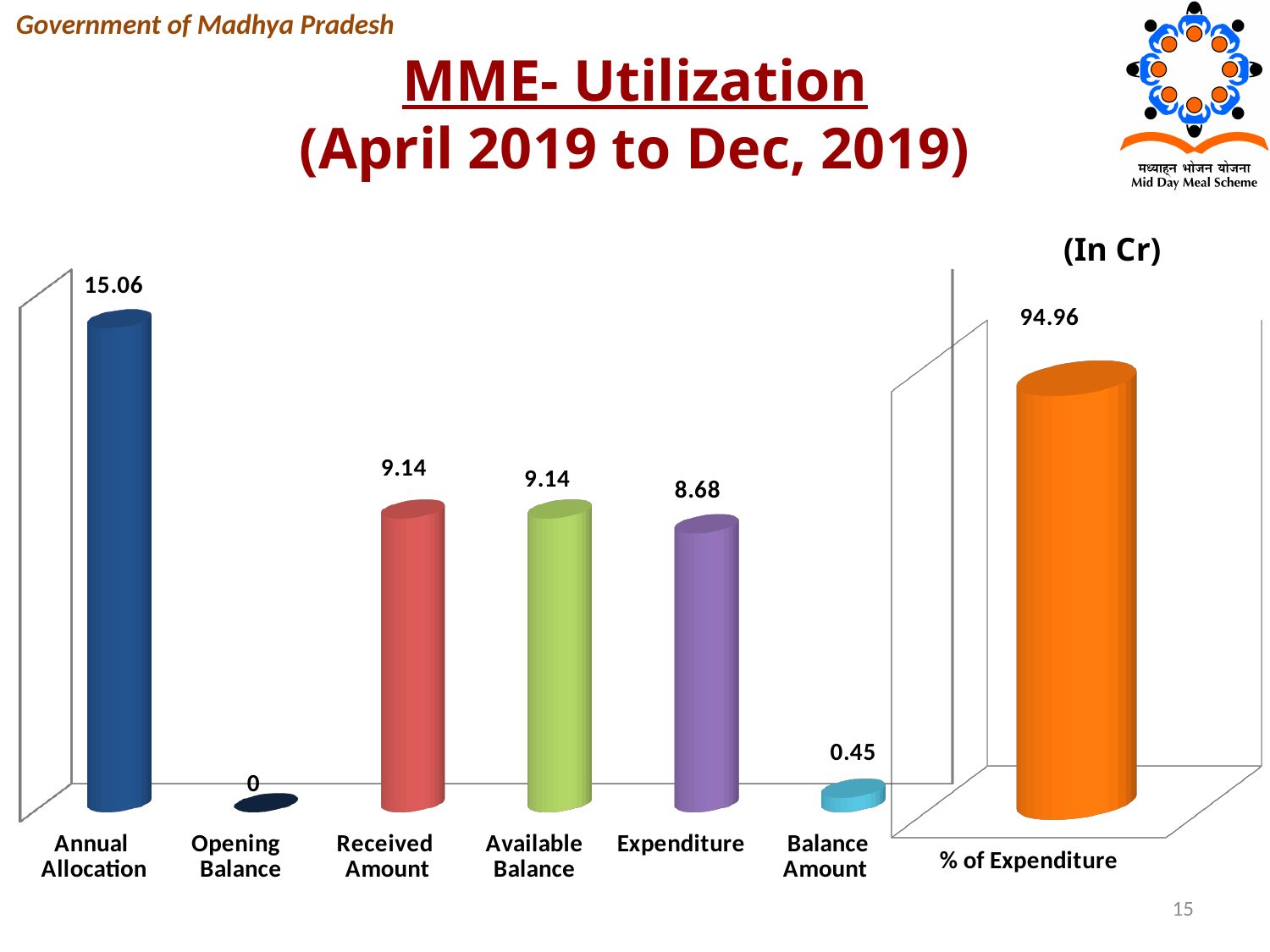
On the left chart, what is the value for Balance Amount? 0.45 On the left chart, what is the difference between Annual Allocation and Received Amount? 5.92 On the left chart, what is the difference between Available Balance and Expenditure? 0.46 On the right chart, what is the value for % of Expenditure? 94.96 On the left chart, which is larger, Received Amount or Expenditure? Received Amount On the left chart, what is the value for Annual Allocation? 15.06 On the left chart, which category has the highest value? Annual Allocation On the left chart, which category has the lowest value? Opening Balance What kind of chart is the left chart? Bar chart On the left chart, what is the value for Expenditure? 8.68 How many categories are shown on the left chart? 6 On the left chart, what is the value for Opening Balance? 0